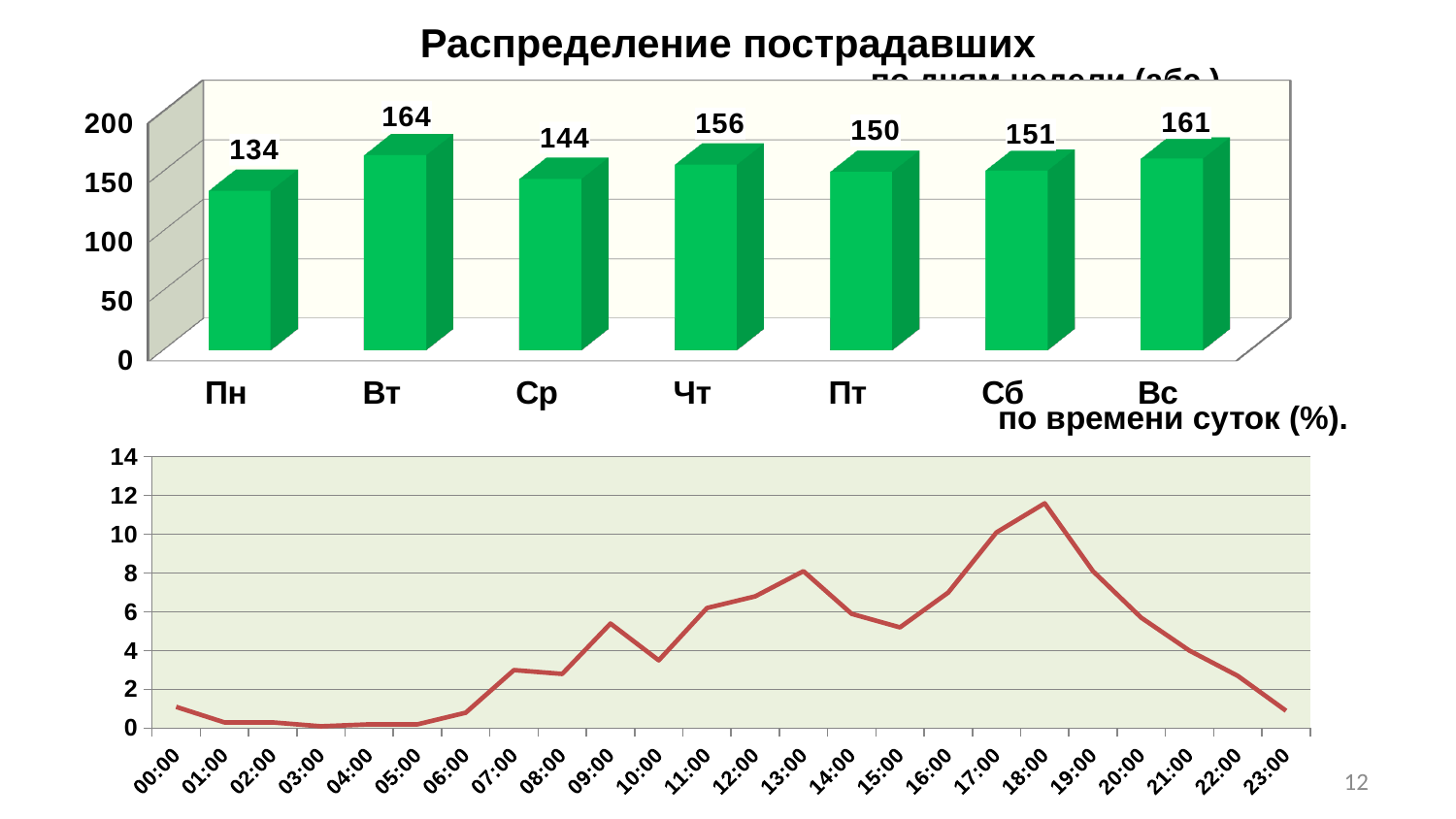
In the bottom line chart, is the value at 18:00 greater or less than 10? greater In the top bar chart, which day has the lowest value? Пн In the bottom line chart, do the values rise or fall from 18:00 to 23:00? fall In the top bar chart, what is the difference between the values for Вт and Пн? 30 In the top bar chart, which day has the highest value? Вт In the bottom line chart, at which time is the value highest? 18:00 In the top bar chart, what is the value for Вт? 164 What kind of chart is the top chart on the slide? bar chart In the top bar chart, what is the value for Сб? 151 In the top bar chart, which is larger, the value for Чт or the value for Ср? Чт In the top bar chart, what is the value for Пн? 134 How many categories does the top bar chart show? 7